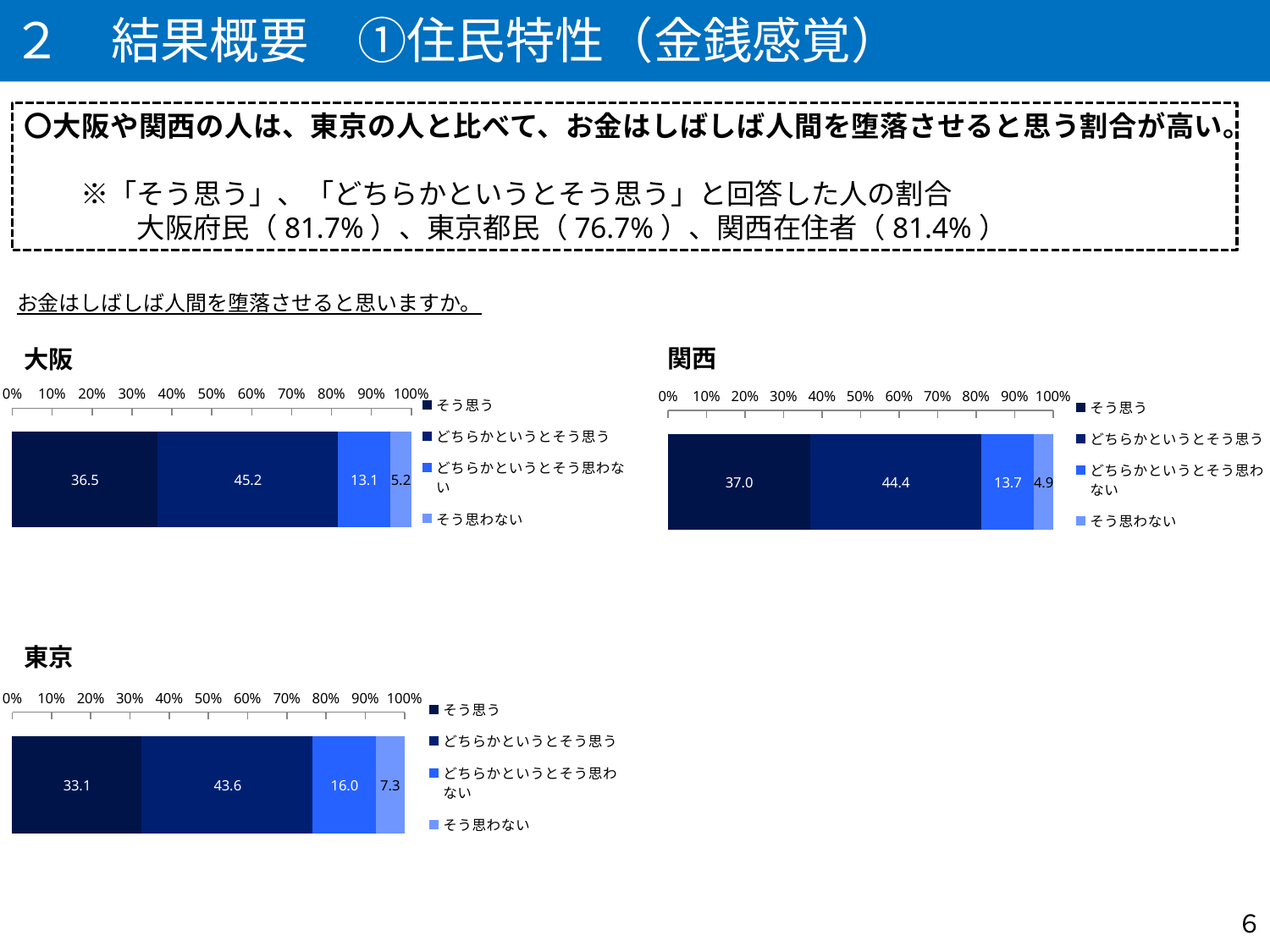
Which is larger: the そう思わない value in the 東京 chart or in the 大阪 chart? 東京 In the 関西 chart, what is the value for どちらかというとそう思う? 44.4 In the 大阪 chart, which response category has the largest share? どちらかというとそう思う In the 関西 chart, which response category has the smallest share? そう思わない In the 大阪 chart, what is the value for そう思う? 36.5 How many charts are shown on the slide? 3 In the 東京 chart, what is the combined total of そう思う and どちらかというとそう思う? 76.7 What is the difference between the そう思う values in the 大阪 chart and the 東京 chart? 3.4 How many series does the legend of the 関西 chart list? 4 In the 東京 chart, what is the value for そう思わない? 7.3 In the 東京 chart, what is the value for どちらかというとそう思わない? 16.0 What kind of chart is the 東京 chart? Stacked bar chart